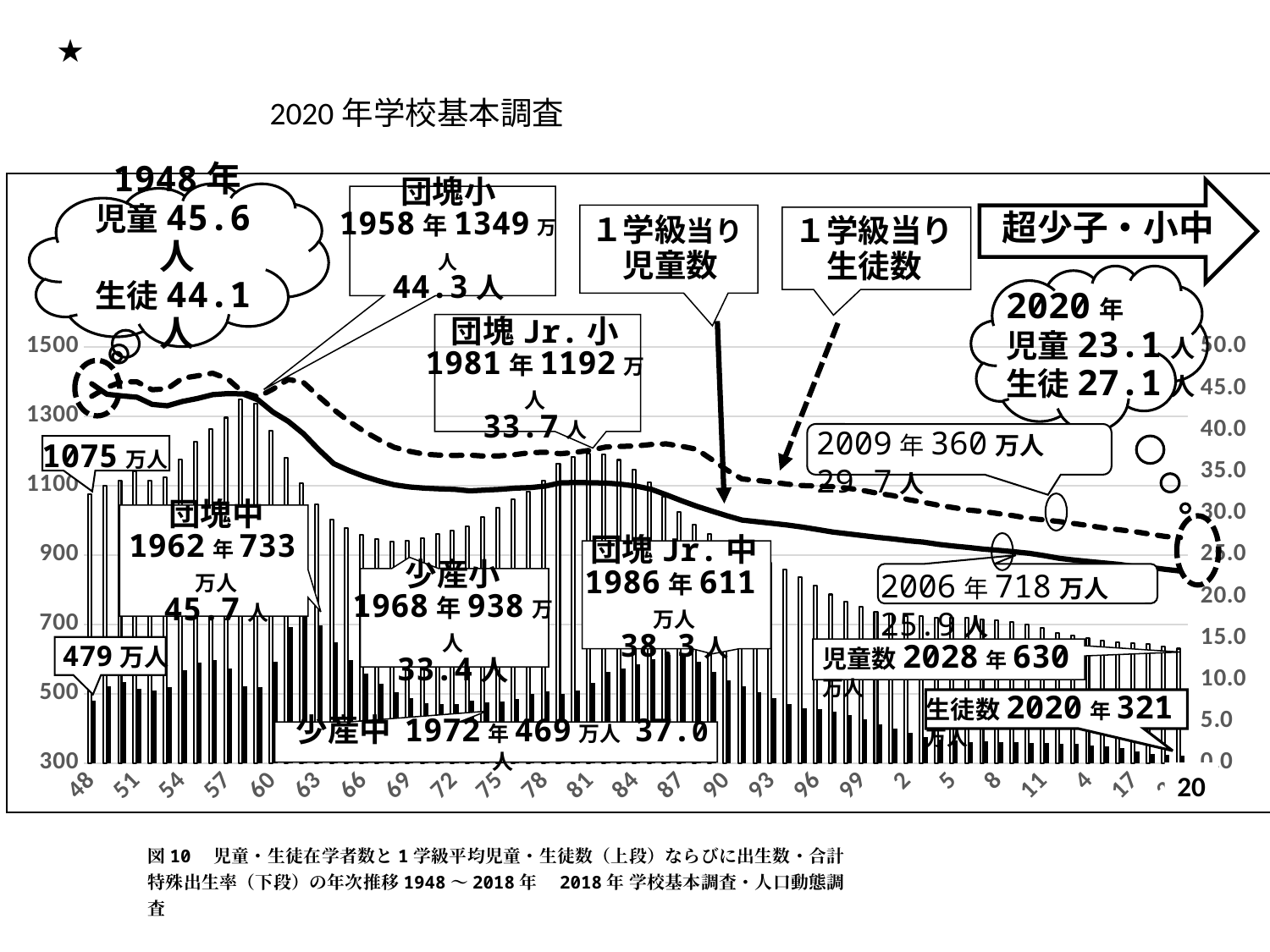
Is the number of 児童 in 1948 (1075万人) greater or less than 1100 on the left axis? less What was the average number of 生徒 per class (1学級当り生徒数) in 2020? 27.1人 What is the difference between the number of 児童 in 1958 (1349万人) and in 1981 (1192万人)? 157万人 According to the annotation, what was the number of 児童 in 1981 (団塊Jr.小)? 1192万人 What is the difference between the number of 生徒 in 1962 (733万人) and in 1986 (611万人)? 122万人 What kind of chart is shown on the slide? A bar chart combined with line charts According to the annotation, what was the number of 児童 (elementary pupils) in 1958 (団塊小)? 1349万人 Does the 1学級当り児童数 line (solid) rise or fall overall from 1948 to 2020? Fall Which was larger, the number of 児童 in 1958 or in 1981? 1958 What was the number of 生徒 in 2020 according to the annotation? 321万人 What was the number of 生徒 (junior high students) in 1962 (団塊中)? 733万人 What was the average number of 児童 per class (1学級当り児童数) in 1948? 45.6人